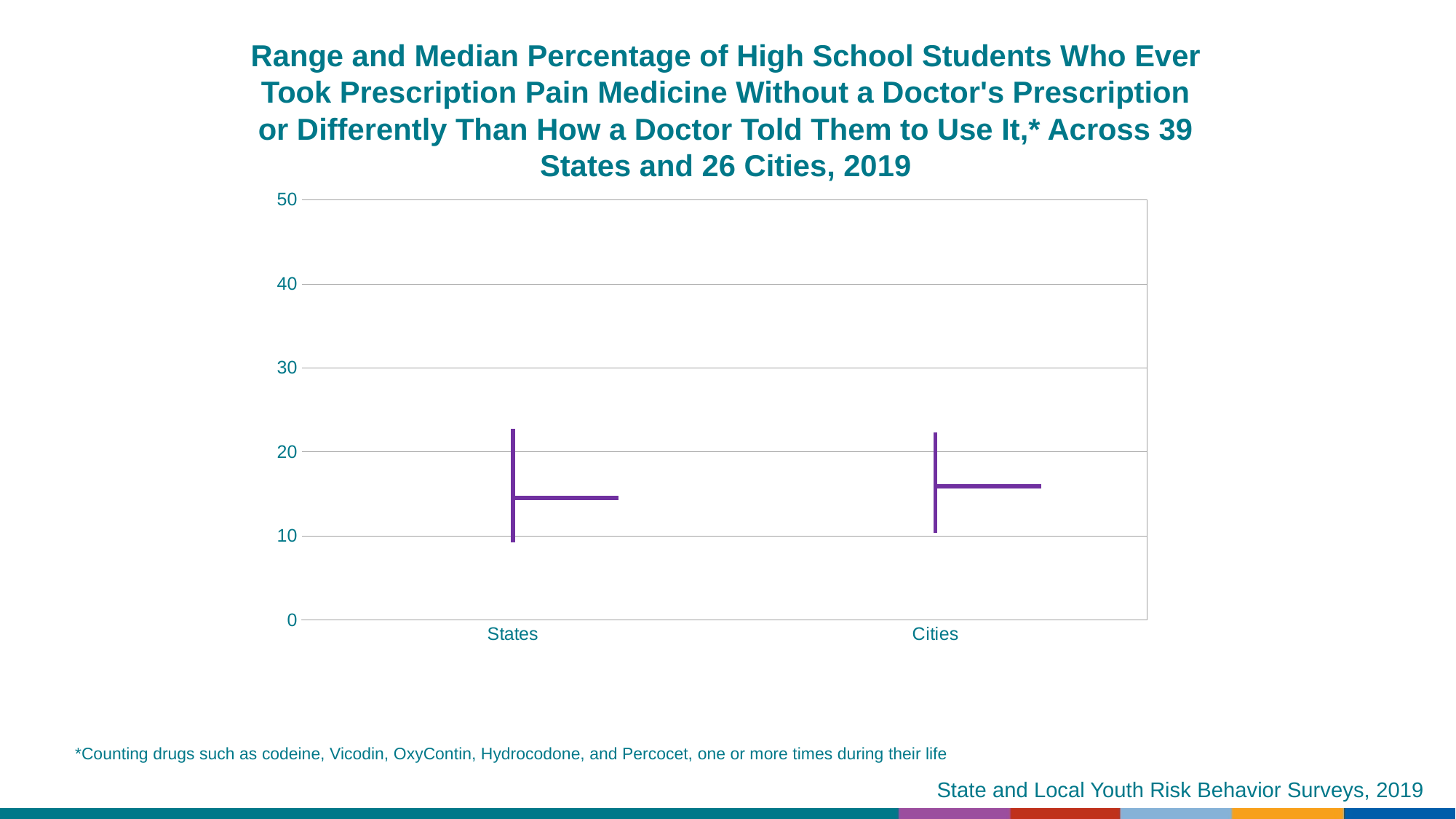
What kind of chart is this? A high-low range chart with median markers What is the highest value shown on the y axis? 50 Is the median value for Cities greater or less than 20? less What are the two categories shown on the x axis? States and Cities Is the top of the range for Cities greater or less than 20? greater Is the median value for States greater or less than 20? less How many categories are shown on the x axis of the chart? 2 Which category has the higher median value, States or Cities? Cities What year does the chart title say the data are from? 2019